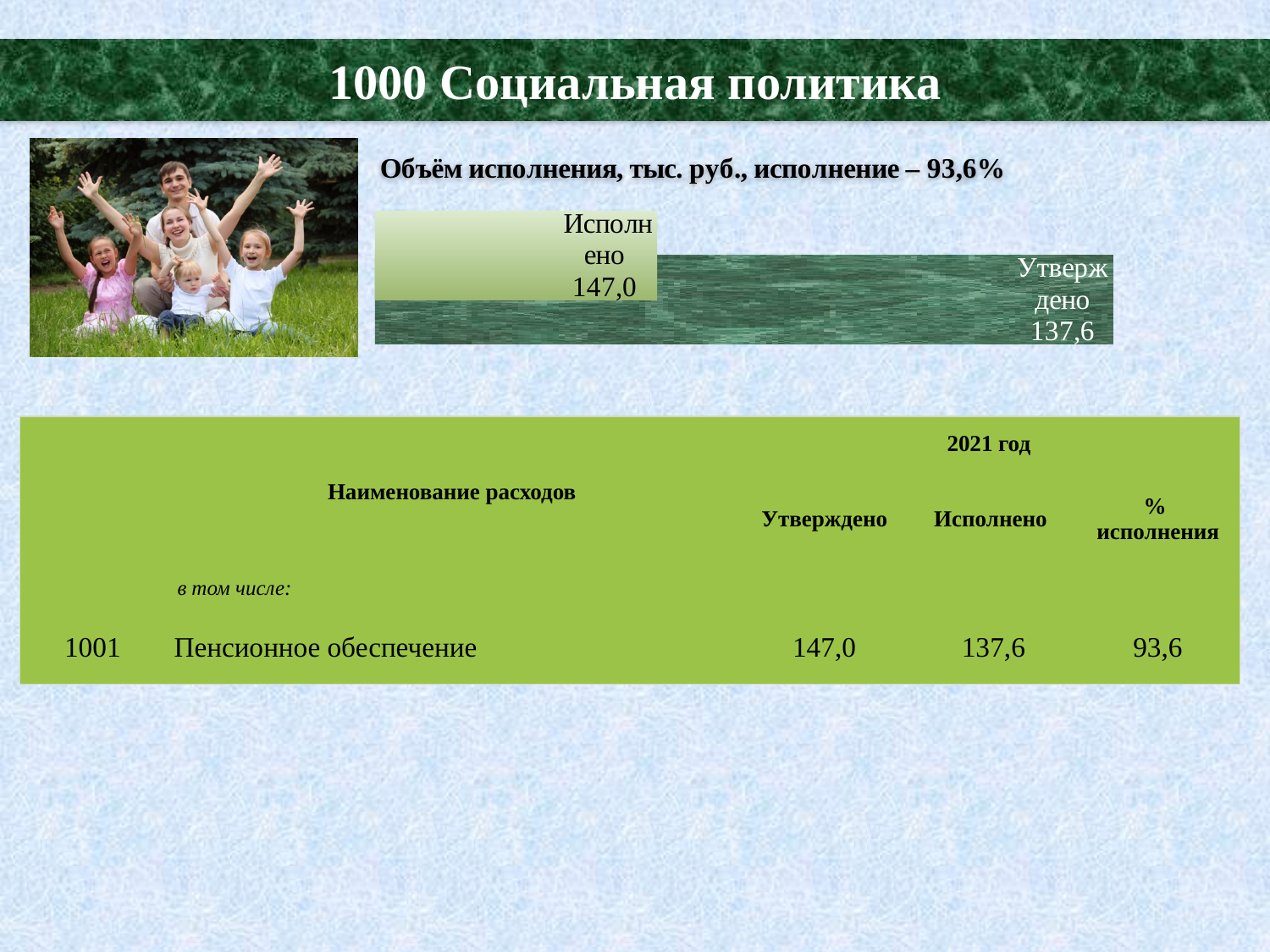
What value is printed on the bar labelled Утверждено in the chart? 137,6 What is the difference between the two values printed on the chart, 147,0 and 137,6? 9,4 What value is printed on the bar labelled Исполнено in the chart? 147,0 What kind of chart is shown on the slide? bar chart What percentage of execution is stated in the chart title? 93,6% Which printed value in the chart is larger, the one labelled Исполнено or the one labelled Утверждено? Исполнено How many bars does the chart contain? 2 What is the title text above the chart? Объём исполнения, тыс. руб., исполнение – 93,6%